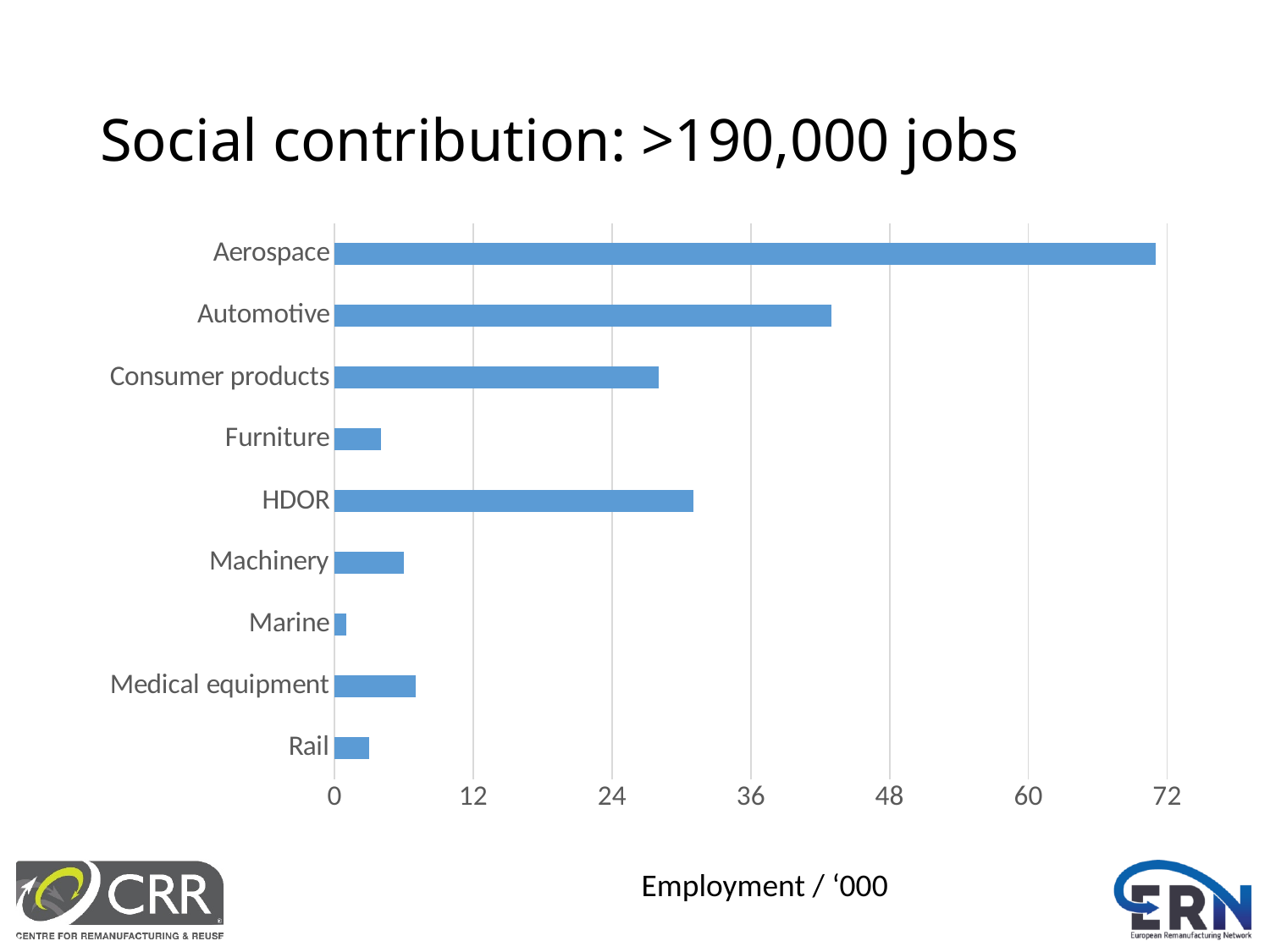
Which category has the highest employment in the chart? Aerospace How many categories are plotted in the chart? 9 Which has the larger value, Medical equipment or Rail? Medical equipment Which has the larger value, Automotive or Consumer products? Automotive Is the value for Aerospace greater or less than 60? greater Which category has the lowest employment in the chart? Marine What is the title of the slide containing the chart? Social contribution: >190,000 jobs Is the value for Furniture greater or less than 12? less What kind of chart is shown on the slide? bar chart Is the value for HDOR greater or less than 24? greater What is the label of the horizontal axis of the chart? Employment / '000